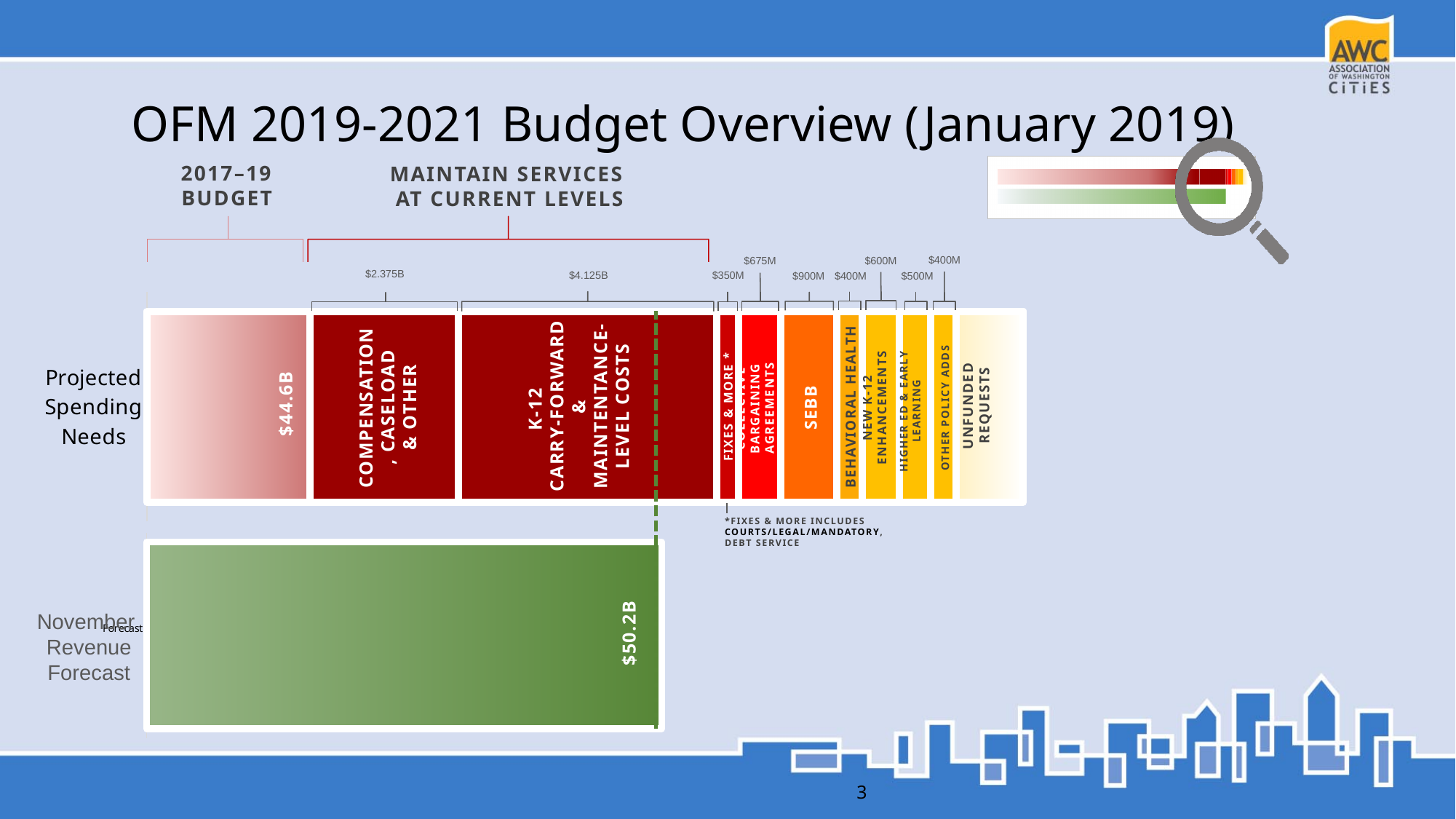
Which segment of the Projected Spending Needs bar is the largest? 2017–19 Budget What is the combined value of the two segments under 'Maintain Services at Current Levels'? $6.5B Which is larger, the SEBB segment or the Behavioral Health segment? SEBB What value is shown for the K-12 Carry-Forward & Maintenance-Level Costs segment? $4.125B What kind of chart is shown on the slide? Bar chart What is the value of the November Revenue Forecast bar? $50.2B What value is shown for the SEBB segment? $900M What value is shown for the Compensation, Caseload & Other segment? $2.375B What is the difference between the K-12 Carry-Forward & Maintenance-Level Costs segment and the Compensation, Caseload & Other segment? $1.75B What colour is the November Revenue Forecast bar? Green What value is shown for the Collective Bargaining Agreements segment? $675M What is the value shown for the 2017–19 Budget segment of the Projected Spending Needs bar? $44.6B